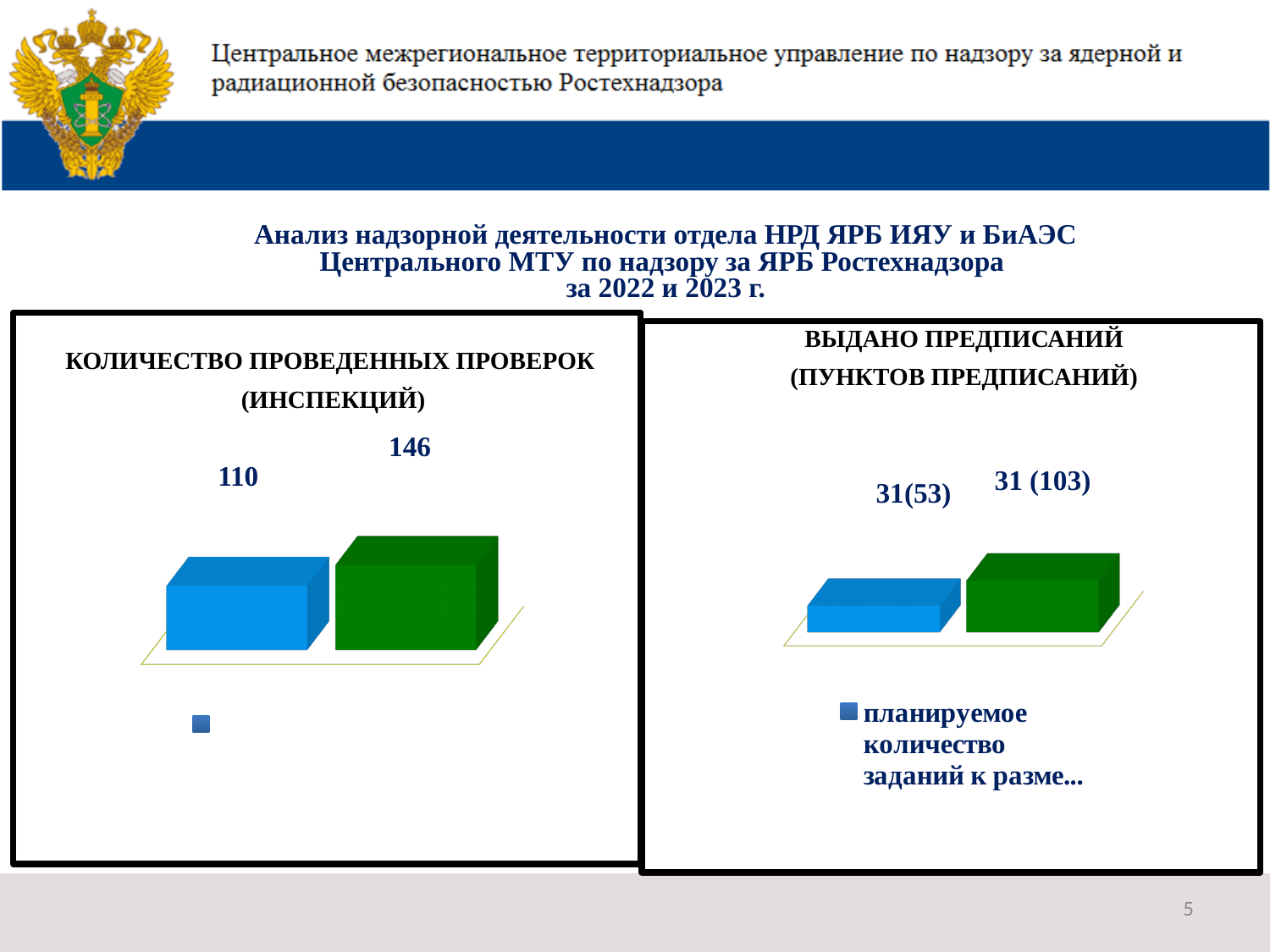
In the right chart (ВЫДАНО ПРЕДПИСАНИЙ), what label is shown on the green bar? 31 (103) In the right chart (ВЫДАНО ПРЕДПИСАНИЙ), what label is shown on the blue bar? 31(53) What type of chart is the left chart (КОЛИЧЕСТВО ПРОВЕДЕННЫХ ПРОВЕРОК)? bar chart How many bars are plotted in the left chart (КОЛИЧЕСТВО ПРОВЕДЕННЫХ ПРОВЕРОК)? 2 In the left chart (КОЛИЧЕСТВО ПРОВЕДЕННЫХ ПРОВЕРОК), what value is shown on the blue bar? 110 In the left chart (КОЛИЧЕСТВО ПРОВЕДЕННЫХ ПРОВЕРОК), which bar has the highest value? the green bar (146) In the left chart (КОЛИЧЕСТВО ПРОВЕДЕННЫХ ПРОВЕРОК), what value is shown on the green bar? 146 In the left chart (КОЛИЧЕСТВО ПРОВЕДЕННЫХ ПРОВЕРОК), which bar has the lowest value? the blue bar (110) In the left chart (КОЛИЧЕСТВО ПРОВЕДЕННЫХ ПРОВЕРОК), what is the difference between the green bar and the blue bar? 36 In the right chart (ВЫДАНО ПРЕДПИСАНИЙ), which bar is taller, the blue one or the green one? the green bar What is the title of the right chart? ВЫДАНО ПРЕДПИСАНИЙ (ПУНКТОВ ПРЕДПИСАНИЙ) In the left chart (КОЛИЧЕСТВО ПРОВЕДЕННЫХ ПРОВЕРОК), is the blue bar or the green bar larger? the green bar